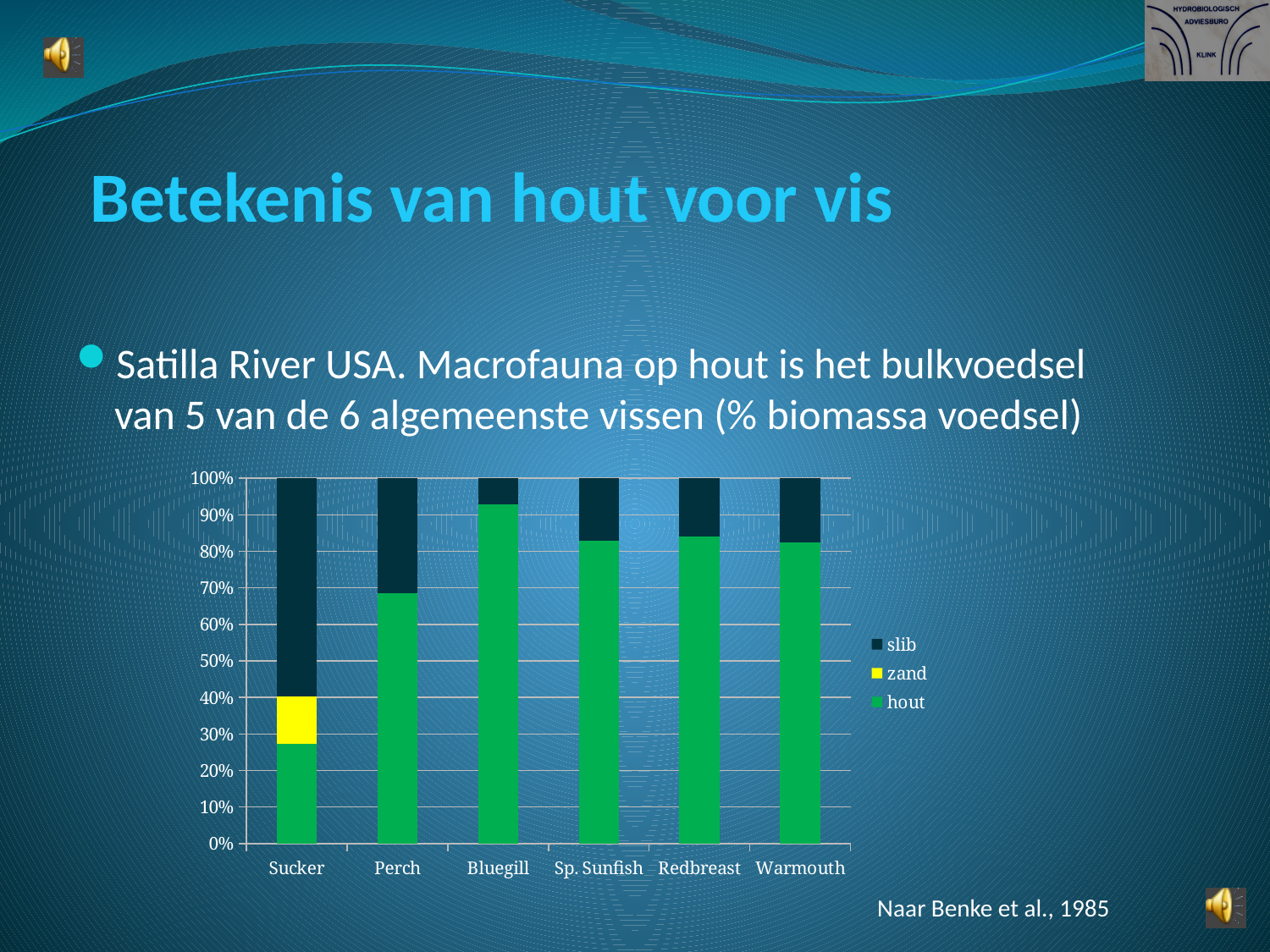
Is the 'hout' share for Bluegill greater or less than 90%? greater Which fish has the largest share of 'slib'? Sucker Which has a larger 'hout' share, Perch or Warmouth? Warmouth Which fish has the highest share of 'hout' in its food biomass? Bluegill Which is the only fish whose bar includes a 'zand' segment? Sucker How many series does the chart legend list? 3 Is the 'hout' share for Sucker greater or less than 30%? less What kind of chart is shown on the slide? stacked bar chart Which fish has the lowest share of 'hout' in its food biomass? Sucker Is the 'hout' share for Perch greater or less than 60%? greater Which series are listed in the chart legend? slib, zand, hout How many fish species (categories) are shown on the x axis of the chart? 6